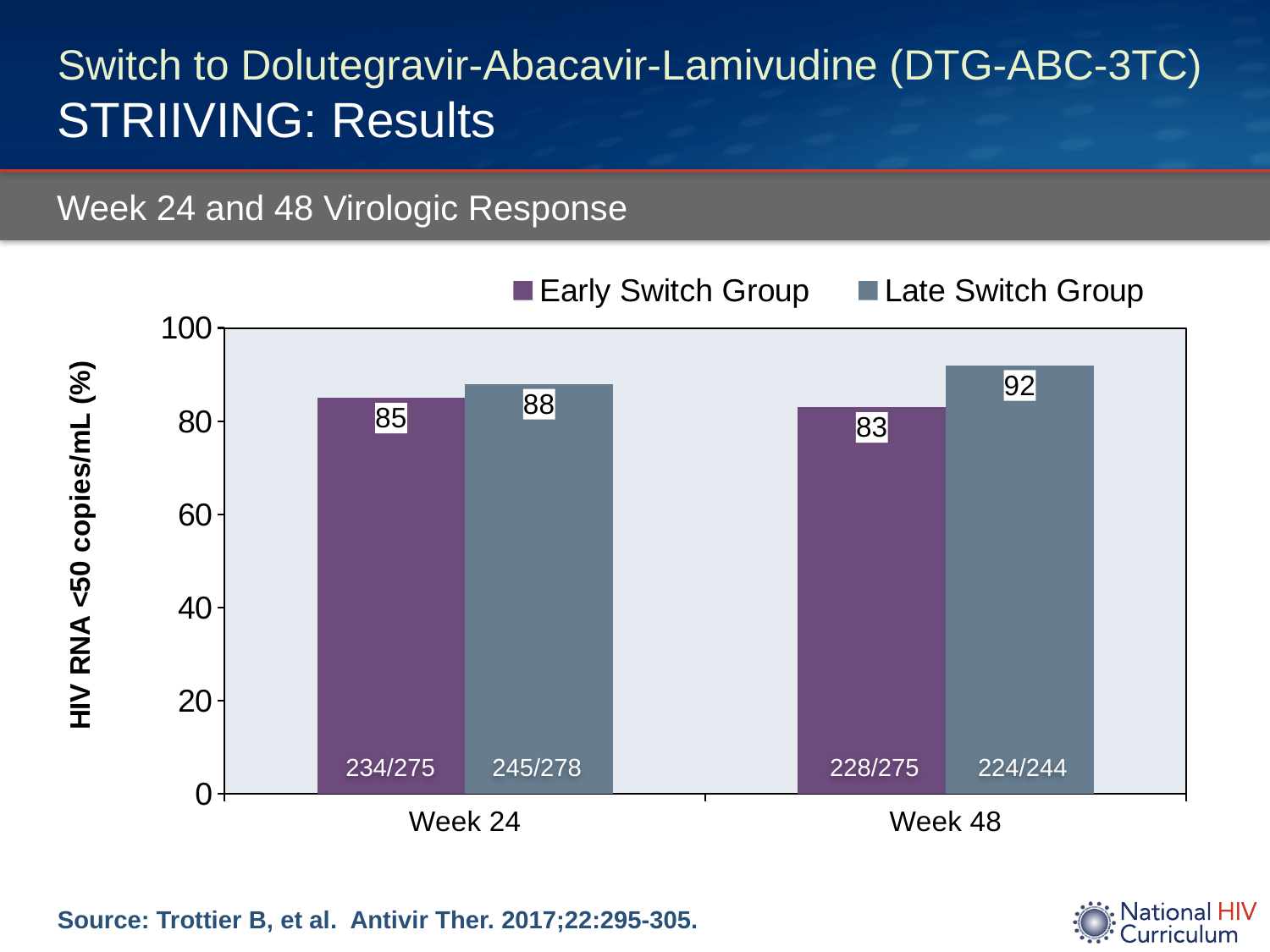
How many series does the legend list? 2 What is the value for the Early Switch Group at Week 48? 83 What is the fraction printed on the Late Switch Group bar at Week 48? 224/244 At Week 24, which group has the larger value, Early Switch or Late Switch? Late Switch Group What kind of chart is shown? Bar chart Which group and week has the highest value? Late Switch Group at Week 48 What is the value for the Late Switch Group at Week 48? 92 What is the value for the Early Switch Group at Week 24? 85 What is the difference between the Late Switch Group and the Early Switch Group at Week 48? 9 Which group and week has the lowest value? Early Switch Group at Week 48 What is the value for the Late Switch Group at Week 24? 88 How many categories are shown on the x axis? 2